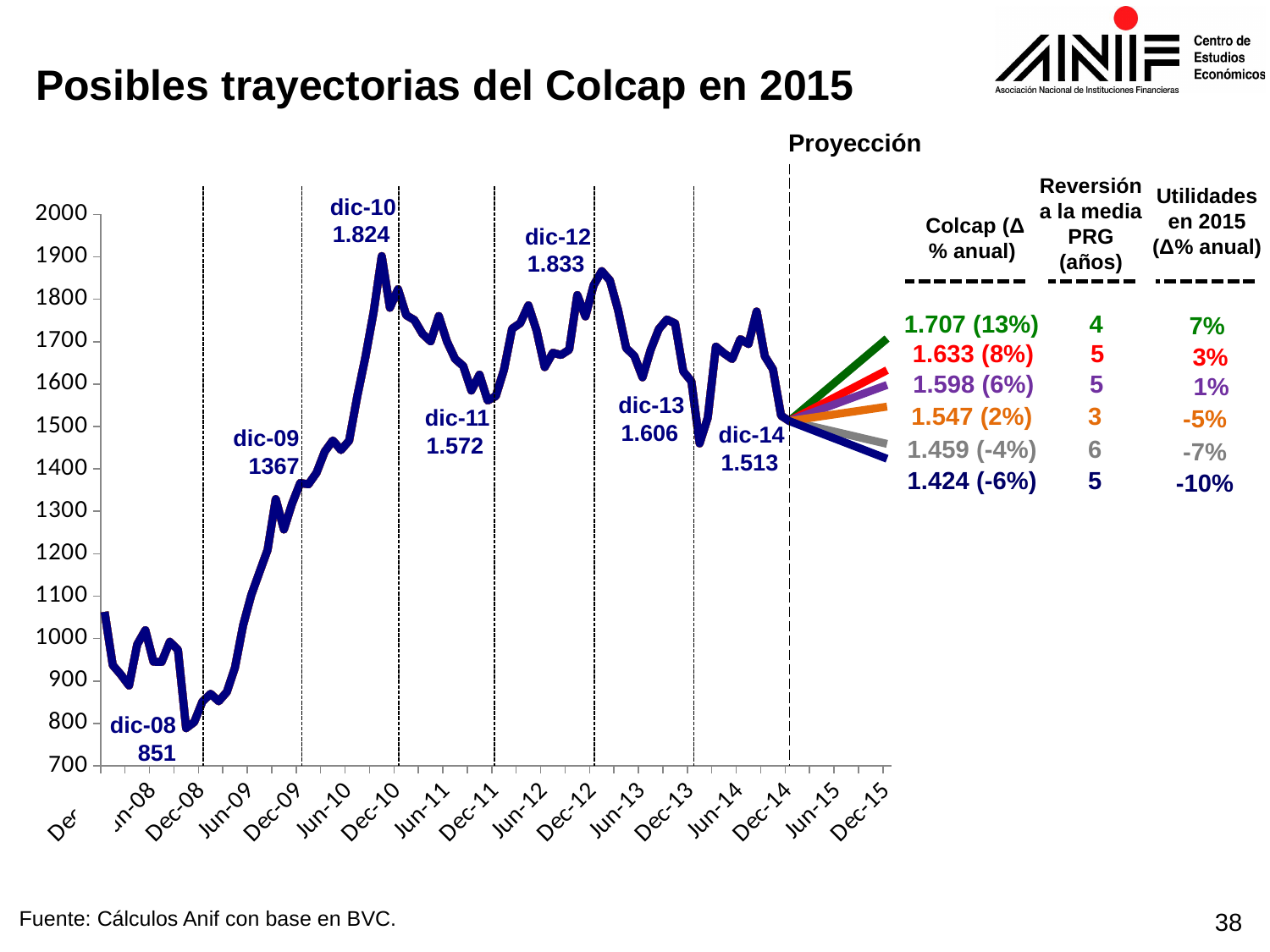
Which labelled December point has the lowest Colcap value? dic-08 What kind of chart is shown on the slide? line chart What is the Colcap value labelled at dic-10? 1.824 Does the Colcap rise or fall between dic-08 and dic-10? rise What is the title of the chart? Posibles trayectorias del Colcap en 2015 Which labelled December point has the highest Colcap value? dic-12 Which is larger, the labelled value at dic-13 or at dic-14? dic-13 What is the difference between the labelled values at dic-09 and dic-08? 516 What is the Colcap value labelled at dic-14? 1.513 What is the highest projected Colcap value for 2015 listed in the table? 1.707 (13%) What is the Colcap value labelled at dic-08? 851 How many projected trajectories for 2015 are shown? 6